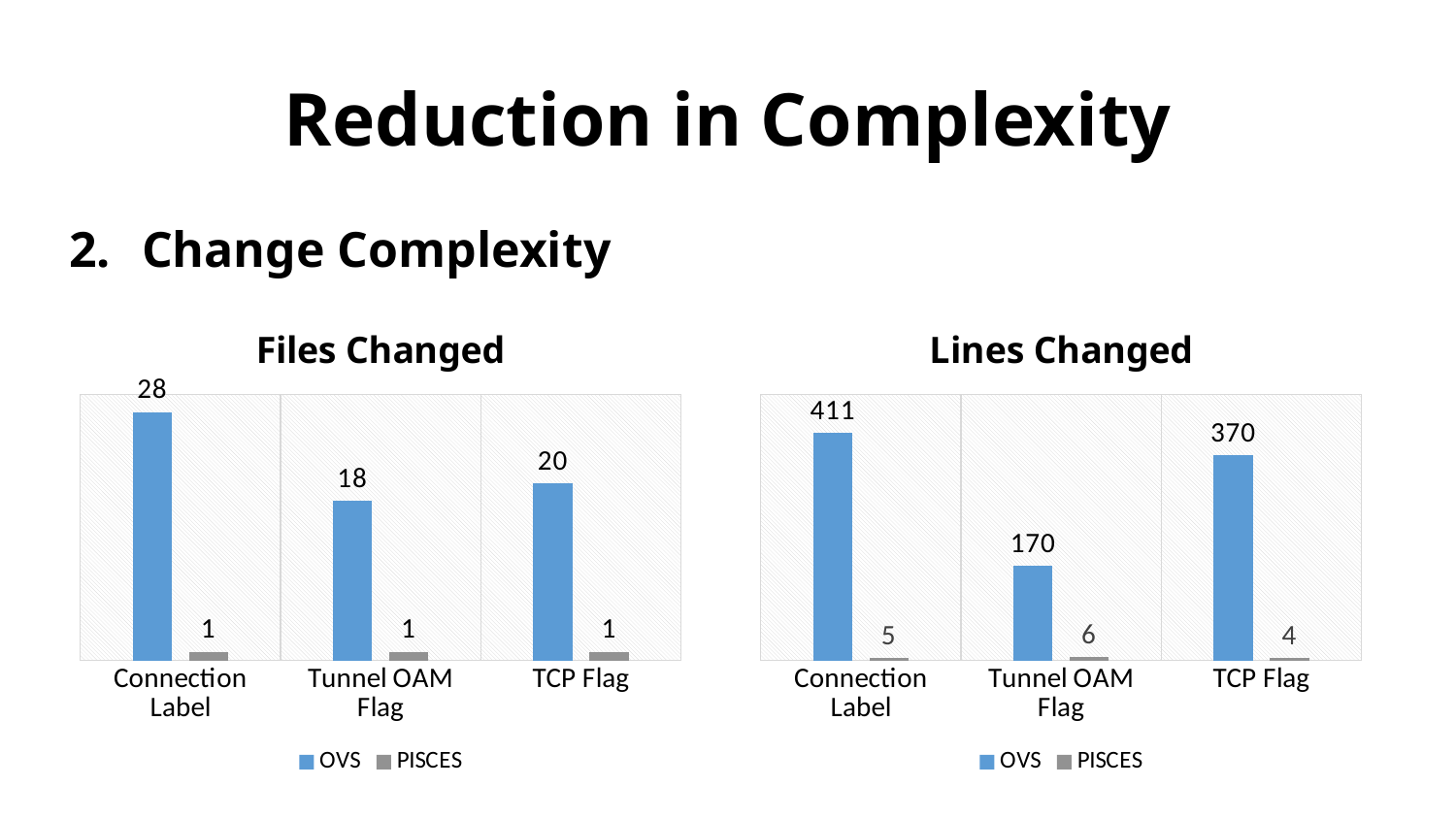
In the Lines Changed chart, what is the OVS value for TCP Flag? 370 How many categories are shown on the x axis of the Files Changed chart? 3 In the Lines Changed chart, which category has the highest OVS value? Connection Label In the Files Changed chart, what is the PISCES value for Tunnel OAM Flag? 1 In the Lines Changed chart, what is the difference between the OVS and PISCES values for Connection Label? 406 In the Files Changed chart, what is the OVS value for Connection Label? 28 How many series does the legend of the Lines Changed chart list? 2 In the Files Changed chart, what is the difference between the OVS values for Connection Label and TCP Flag? 8 In the Lines Changed chart, which is larger: the OVS value for Tunnel OAM Flag or the OVS value for TCP Flag? TCP Flag In the Lines Changed chart, what is the PISCES value for Tunnel OAM Flag? 6 What kind of chart is the Files Changed chart? Bar chart In the Files Changed chart, which category has the lowest OVS value? Tunnel OAM Flag